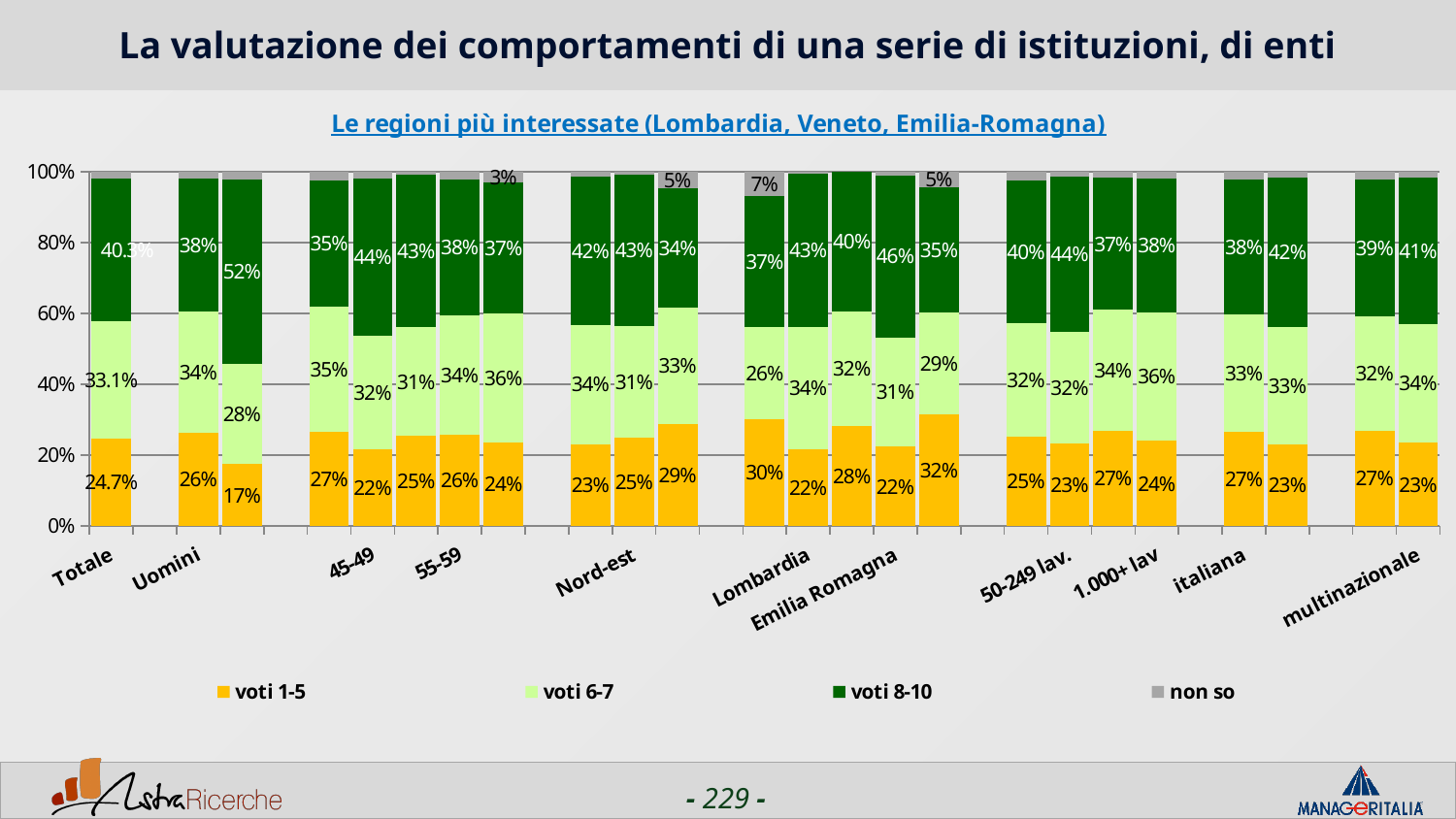
What is the 'voti 1-5' value for Uomini? 26% Is the 'voti 1-5' value for Totale greater or less than 20%? greater Which has the larger 'voti 8-10' value, Totale or Uomini? Totale What is the 'voti 6-7' value for Uomini? 34% What is the difference between the 'voti 6-7' and 'voti 1-5' values for Totale? 8.4 percentage points What kind of chart is shown on the slide? stacked bar chart How many series does the legend list? 4 What is the 'voti 6-7' value for Totale? 33.1% What is the 'voti 1-5' value for Totale? 24.7% What is the first entry in the chart's legend? voti 1-5 What is the 'voti 8-10' value for Totale? 40.3% What is the highest 'voti 8-10' value shown on any bar in the chart? 52%